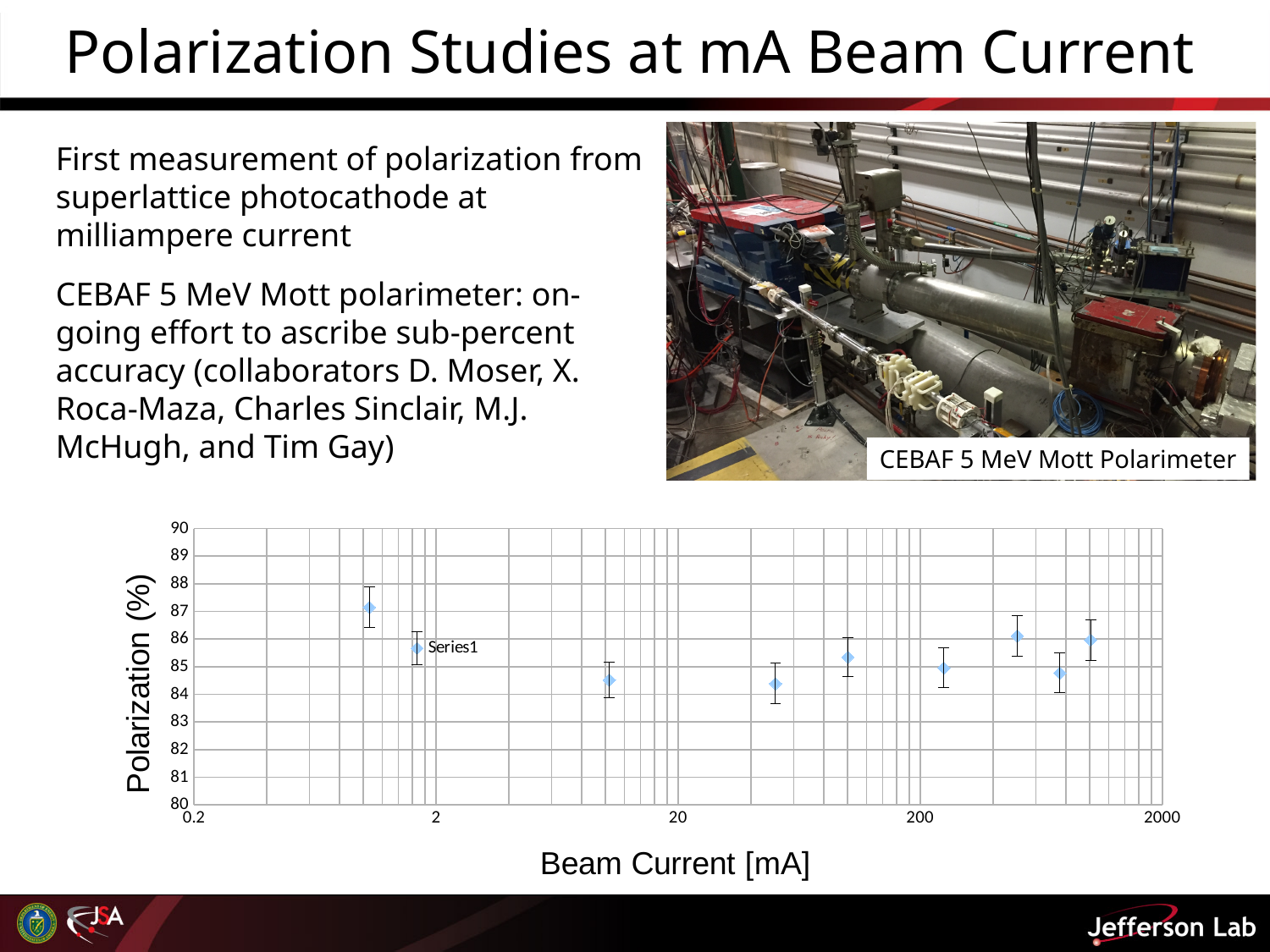
Is the polarization value of the rightmost data point (highest beam current) greater or less than 85? greater Are all plotted polarization values greater or less than 83? greater Which data point has the highest polarization: the one at the lowest beam current or the one at the highest beam current? The one at the lowest beam current What is the label of the x axis of the chart? Beam Current [mA] What is the maximum value shown on the y axis of the chart? 90 Is the polarization value of the data point near 20 mA greater or less than 86? less How many data points are plotted in the chart? 9 What kind of chart is shown on the slide? Scatter chart